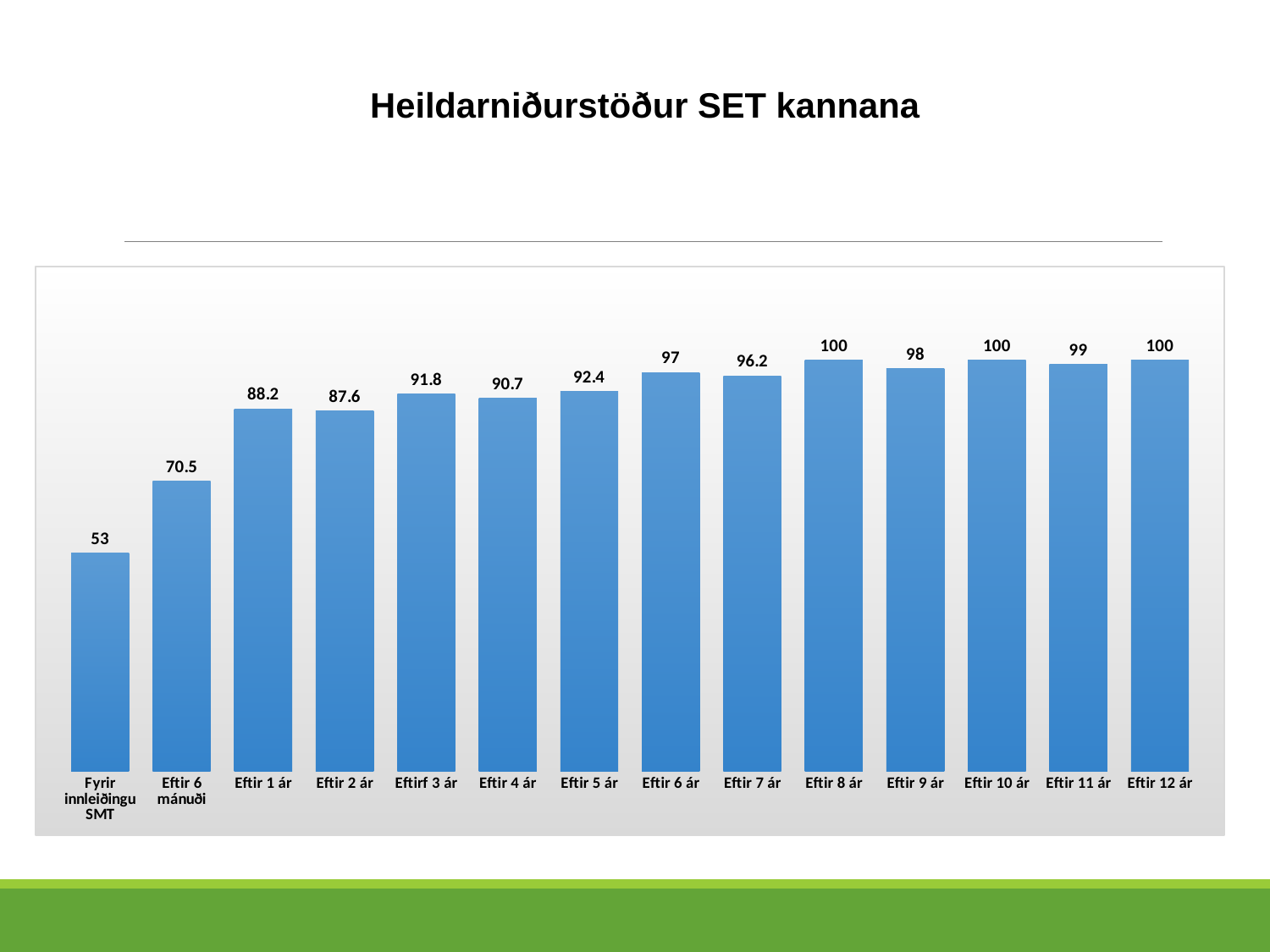
What is the difference between the values for 'Eftir 6 mánuði' and 'Fyrir innleiðingu SMT'? 17.5 What kind of chart is shown on the slide? Bar chart What is the title of the slide? Heildarniðurstöður SET kannana What is the value for 'Eftir 2 ár'? 87.6 What is the difference between the values for 'Eftir 12 ár' and 'Eftir 11 ár'? 1 What is the value for 'Eftir 7 ár'? 96.2 What is the value for 'Eftir 6 mánuði'? 70.5 How many categories are shown on the chart? 14 Which category has the lowest value? Fyrir innleiðingu SMT Which is larger, the value for 'Eftir 1 ár' or 'Eftir 2 ár'? Eftir 1 ár What is the highest value shown on the chart? 100 What is the value for 'Fyrir innleiðingu SMT'? 53